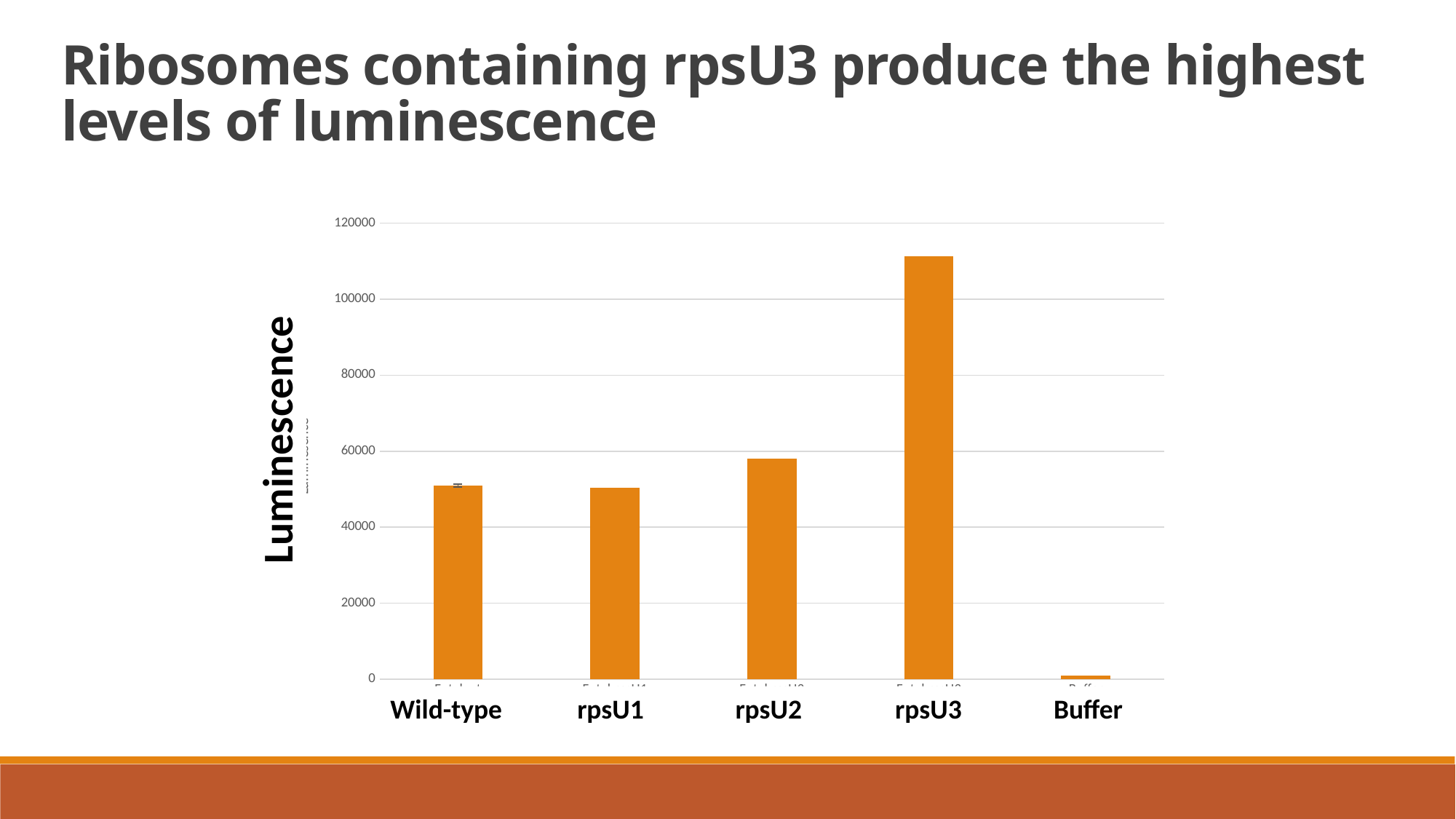
How many categories are plotted on the x axis? 5 Which has a larger value, rpsU2 or rpsU1? rpsU2 What kind of chart is shown on the slide? bar chart Is the value for rpsU3 greater or less than 100000? greater What is the label on the vertical axis of the chart? Luminescence Which category has the lowest luminescence? Buffer Is the value for Wild-type greater or less than 40000? greater Which category has the highest luminescence? rpsU3 Is the value for Buffer greater or less than 20000? less Which has a larger value, Wild-type or rpsU3? rpsU3